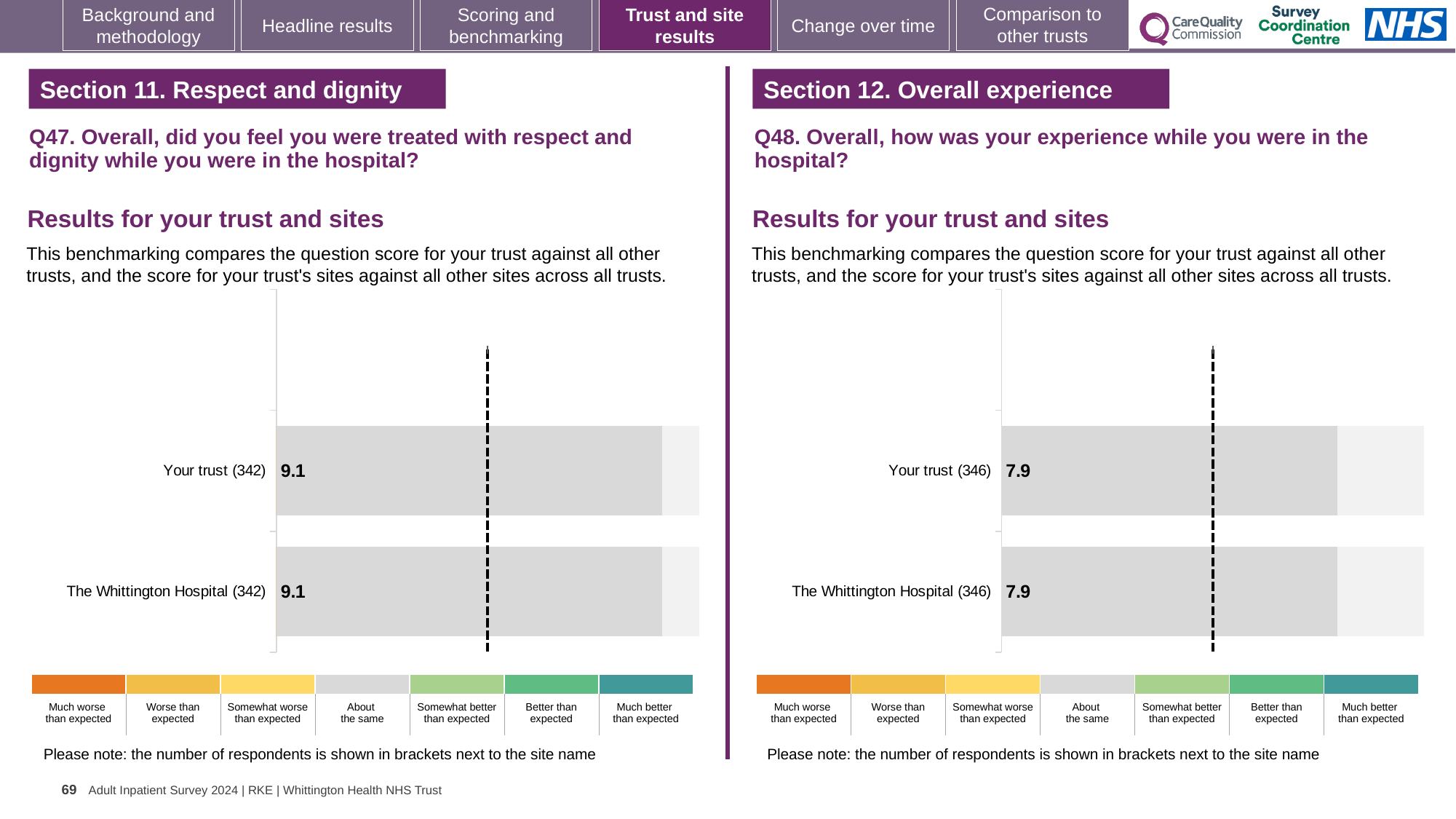
How many bars are plotted in the Q47 chart on the left? 2 In the Q48 chart on the right, what is the difference between the score for Your trust and the score for The Whittington Hospital? 0 In the Q47 chart on the left, what is the score for Your trust? 9.1 In the Q48 chart on the right, what is the score for The Whittington Hospital? 7.9 In the Q48 chart on the right, what is the score for Your trust? 7.9 What kind of chart is used for the Q47 results on the left? Bar chart Is the score for Your trust in the Q47 chart on the left larger than the score for Your trust in the Q48 chart on the right? Yes In the Q47 chart on the left, what is the difference between the score for Your trust and the score for The Whittington Hospital? 0 In the Q47 chart on the left, how many respondents are shown in brackets next to Your trust? 342 How many bars are plotted in the Q48 chart on the right? 2 In the Q47 chart on the left, what is the score for The Whittington Hospital? 9.1 In the Q48 chart on the right, how many respondents are shown in brackets next to The Whittington Hospital? 346